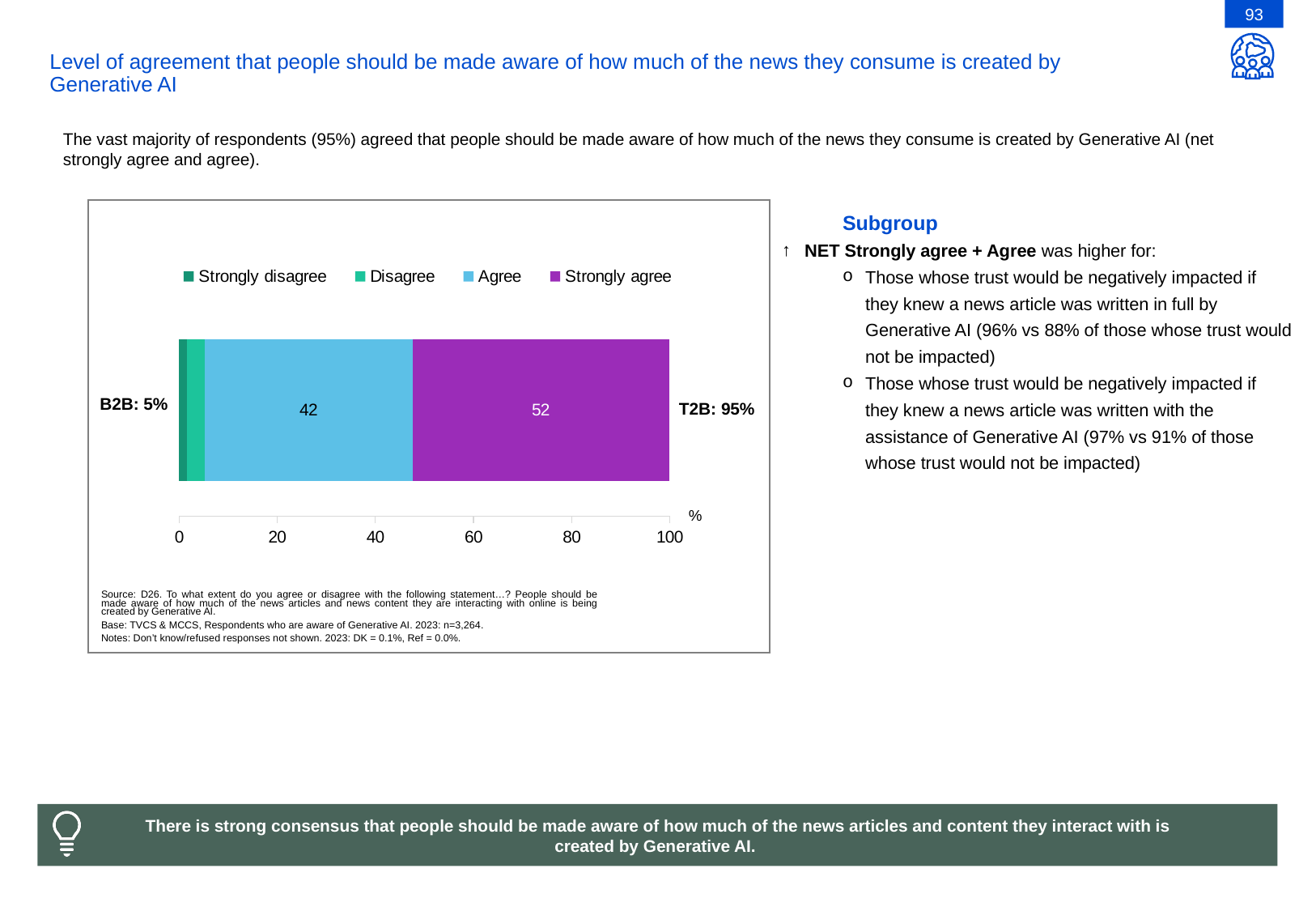
What is the maximum value shown on the horizontal axis? 100 What is the difference between the Strongly agree value and the Agree value? 10 Is the value for Agree greater or less than 40? greater What is the value of the Strongly agree segment in the stacked bar? 52 What T2B value is shown next to the bar? 95% What B2B value is shown next to the bar? 5% How many series does the legend list? 4 What kind of chart is shown on the slide? Stacked bar chart What is the value of the Agree segment in the stacked bar? 42 Which response category has the largest segment in the bar? Strongly agree Which is larger, the Agree segment or the Strongly agree segment? Strongly agree Is the value for Strongly disagree greater or less than 20? less